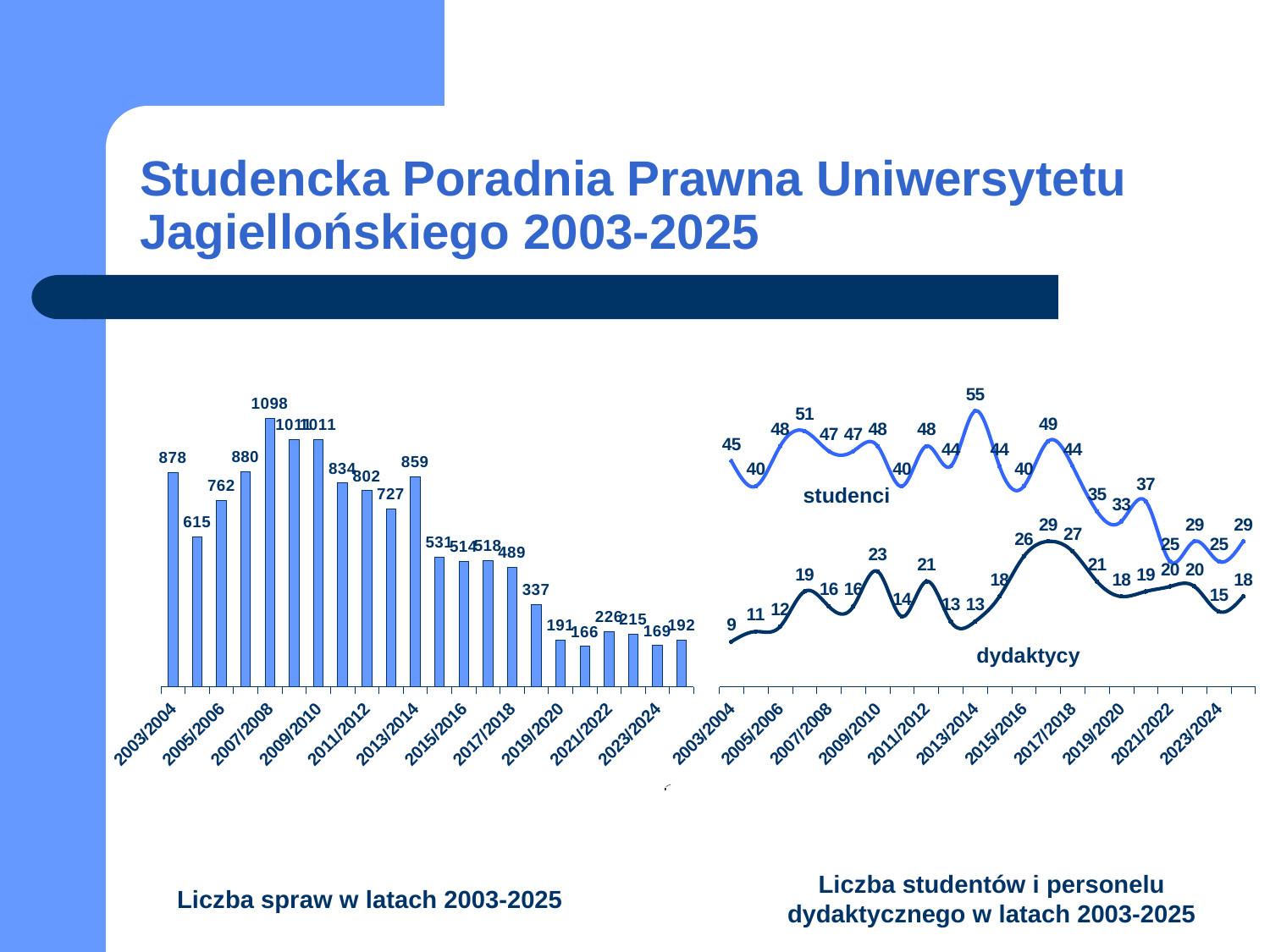
In the right chart (Liczba studentów i personelu dydaktycznego), what is the value for studenci in 2013/2014? 55 In the left chart (Liczba spraw w latach 2003-2025), what is the lowest value shown? 166 In the right chart (Liczba studentów i personelu dydaktycznego), does the studenci line overall rise or fall from 2003/2004 to 2023/2024? fall In the left chart (Liczba spraw w latach 2003-2025), which year has the highest number of cases? 2007/2008 How many series are plotted in the right chart (Liczba studentów i personelu dydaktycznego)? 2 In the left chart (Liczba spraw w latach 2003-2025), what is the value for 2013/2014? 859 In the right chart (Liczba studentów i personelu dydaktycznego), what is the value for dydaktycy in 2003/2004? 9 In the left chart (Liczba spraw w latach 2003-2025), what is the difference between the values for 2003/2004 and 2005/2006? 116 How many bars are in the left chart (Liczba spraw w latach 2003-2025)? 22 In the left chart (Liczba spraw w latach 2003-2025), what is the value for 2003/2004? 878 What kind of chart is the left chart (Liczba spraw w latach 2003-2025)? bar chart In the right chart (Liczba studentów i personelu dydaktycznego), what is the difference between studenci and dydaktycy in 2013/2014? 42